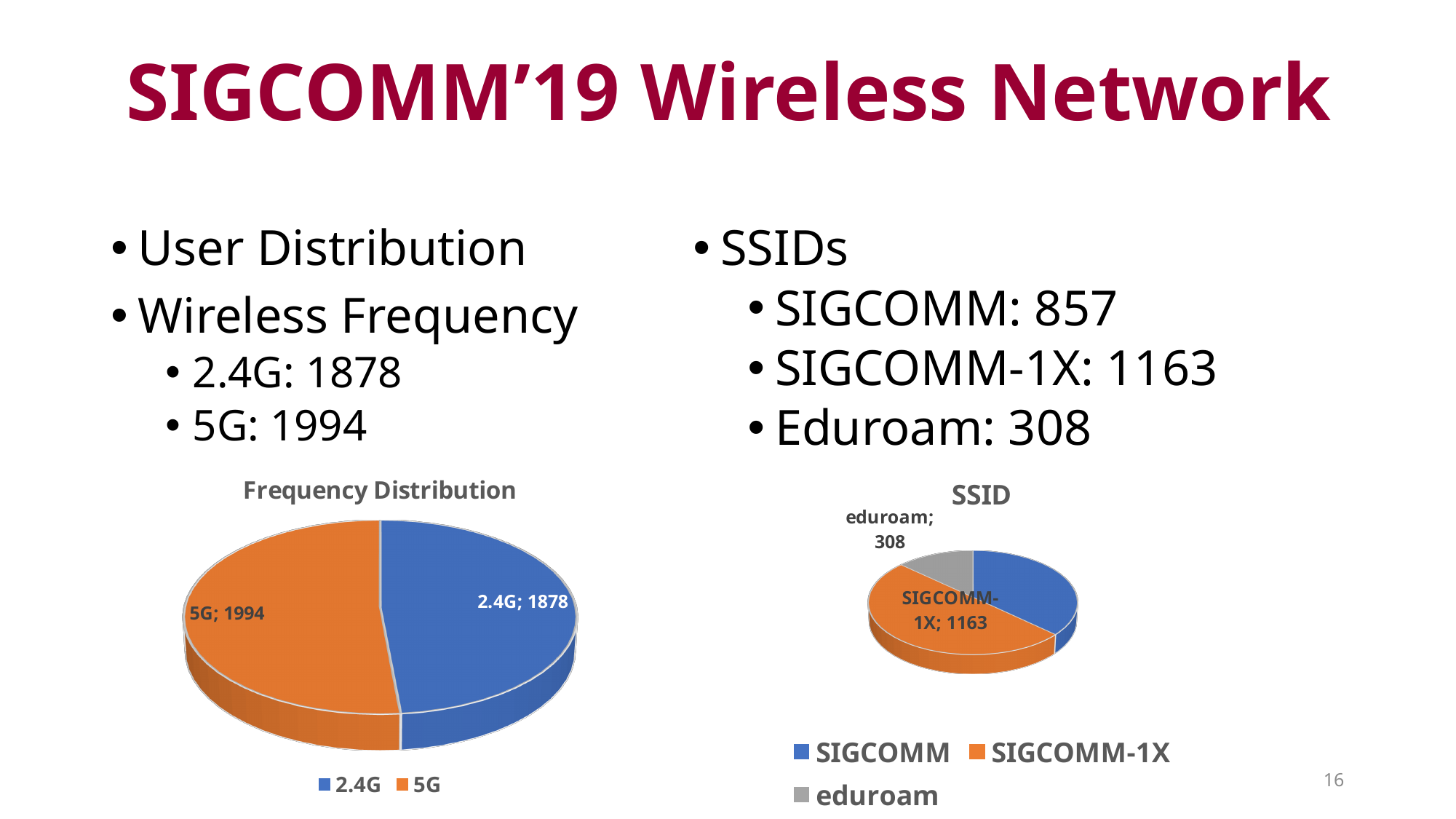
In the Frequency Distribution chart, what is the value for 5G? 1994 In the SSID chart, which SSID has the smallest slice? eduroam In the SSID chart, what is the value for SIGCOMM-1X? 1163 How many entries does the legend of the SSID chart list? 3 In the SSID chart, what is the value for eduroam? 308 In the Frequency Distribution chart, what is the difference between the 5G and 2.4G values? 116 In the Frequency Distribution chart, what is the value for 2.4G? 1878 In the Frequency Distribution chart, what is the total of the two slices? 3872 In the SSID chart, which SSID has the largest slice? SIGCOMM-1X What kind of chart is the Frequency Distribution chart? pie chart In the Frequency Distribution chart, which frequency has the larger slice? 5G How many slices does the Frequency Distribution pie chart have? 2